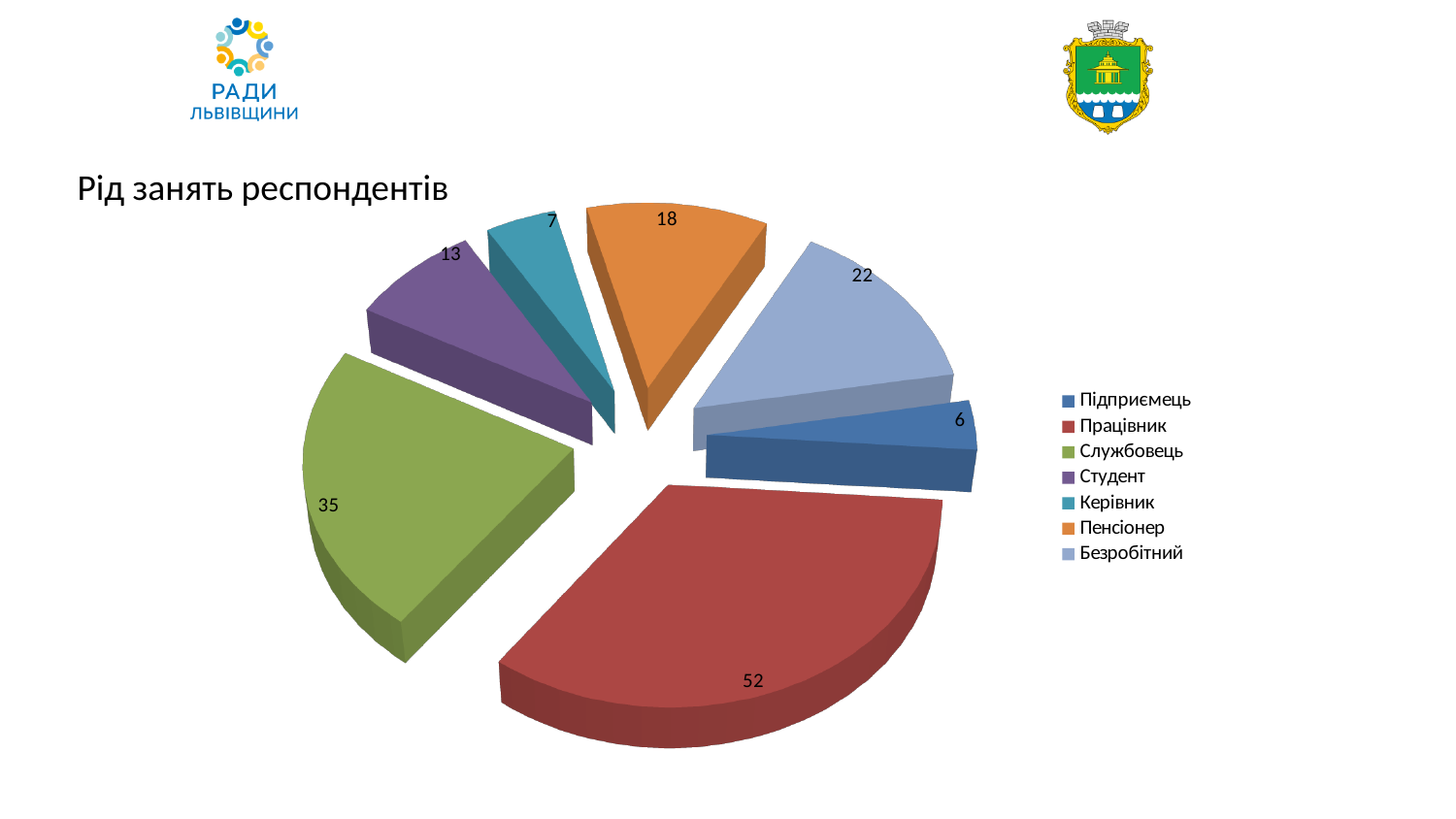
What is the difference between the values for Працівник and Службовець? 17 What is the value for Підприємець? 6 What is the total of all the slice values in the pie chart? 153 What type of chart is shown on the slide? Pie chart What is the value for Працівник? 52 Which category has the largest slice? Працівник What is the title of the chart? Рід занять респондентів What is the value for Безробітний? 22 How many categories does the pie chart have? 7 Which is larger, the value for Студент or the value for Пенсіонер? Пенсіонер What is the value for Службовець? 35 Which category has the smallest slice? Підприємець